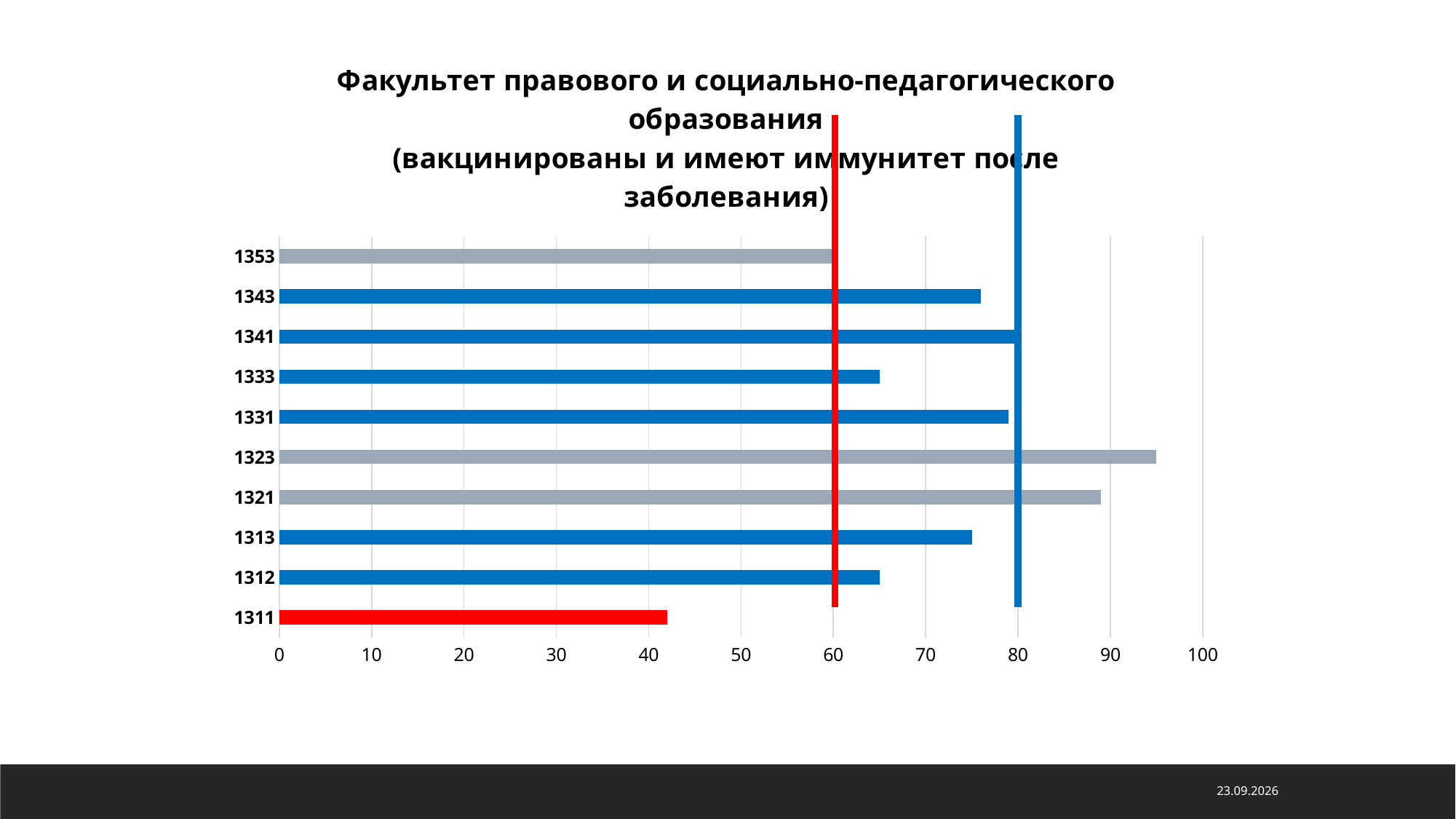
Is the value for group 1343 greater or less than 70? greater Is the value for group 1323 greater or less than 90? greater Which group has the larger value, 1343 or 1333? 1343 Is the value for group 1321 greater or less than 80? greater How many groups (categories) are plotted on the chart? 10 What colour is the bar for group 1311? red What kind of chart is shown on the slide? bar chart Which group has the highest value on the chart? 1323 Which group has the lowest value on the chart? 1311 Which group has the larger value, 1323 or 1321? 1323